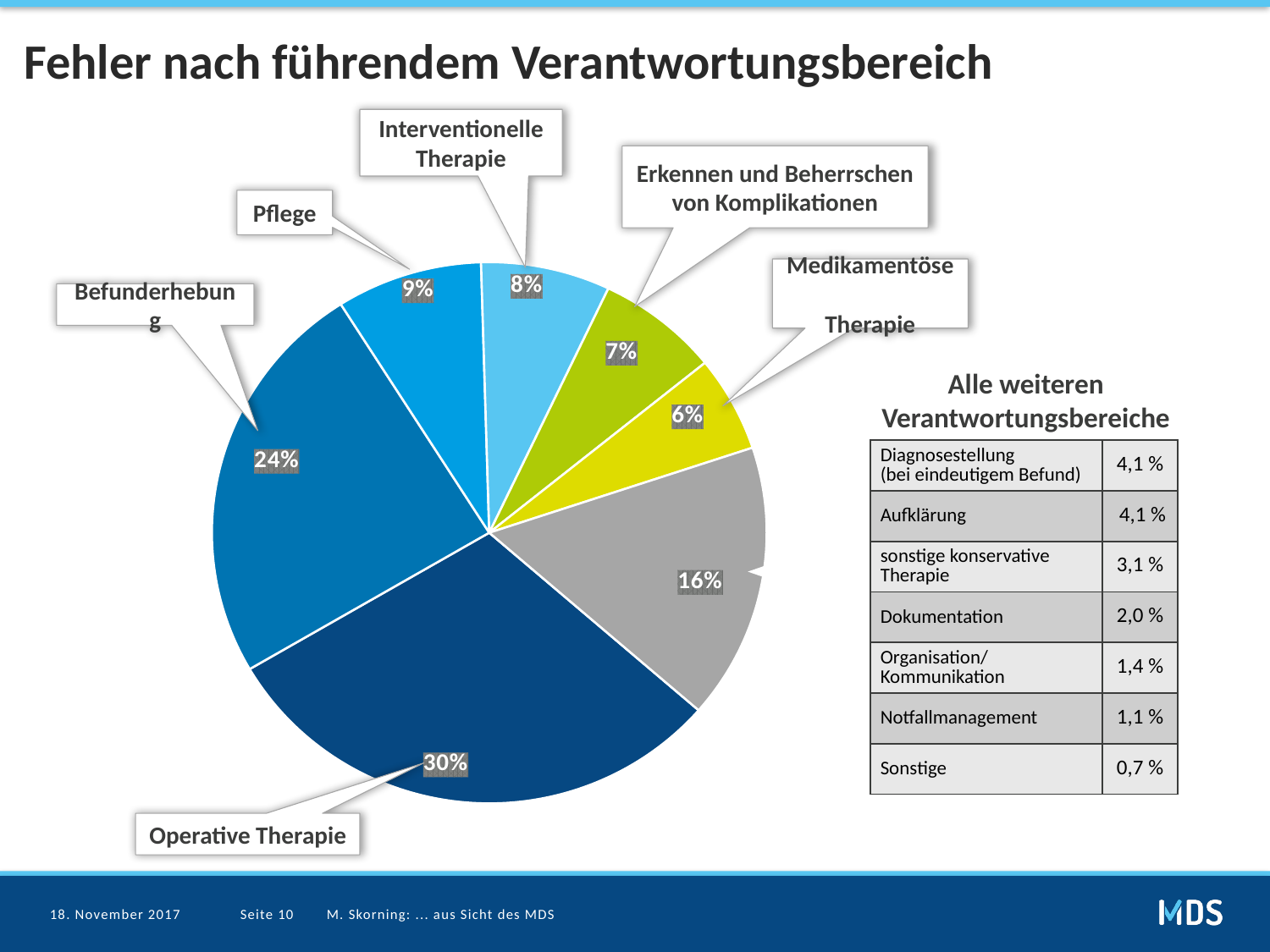
What is the difference between the shares of Operative Therapie and Befunderhebung? 6% What share of the pie does Operative Therapie have? 30% What share of the pie does Befunderhebung have? 24% What is the value shown for Medikamentöse Therapie? 6% How many slices does the pie chart have? 7 What is the value shown for Interventionelle Therapie? 8% What kind of chart is shown on the slide? pie chart Which is larger, the share for Pflege or the share for Interventionelle Therapie? Pflege What is the value shown for Pflege? 9% Which slice of the pie is the largest? Operative Therapie Which slice of the pie is the smallest? Medikamentöse Therapie What is the value shown for Erkennen und Beherrschen von Komplikationen? 7%